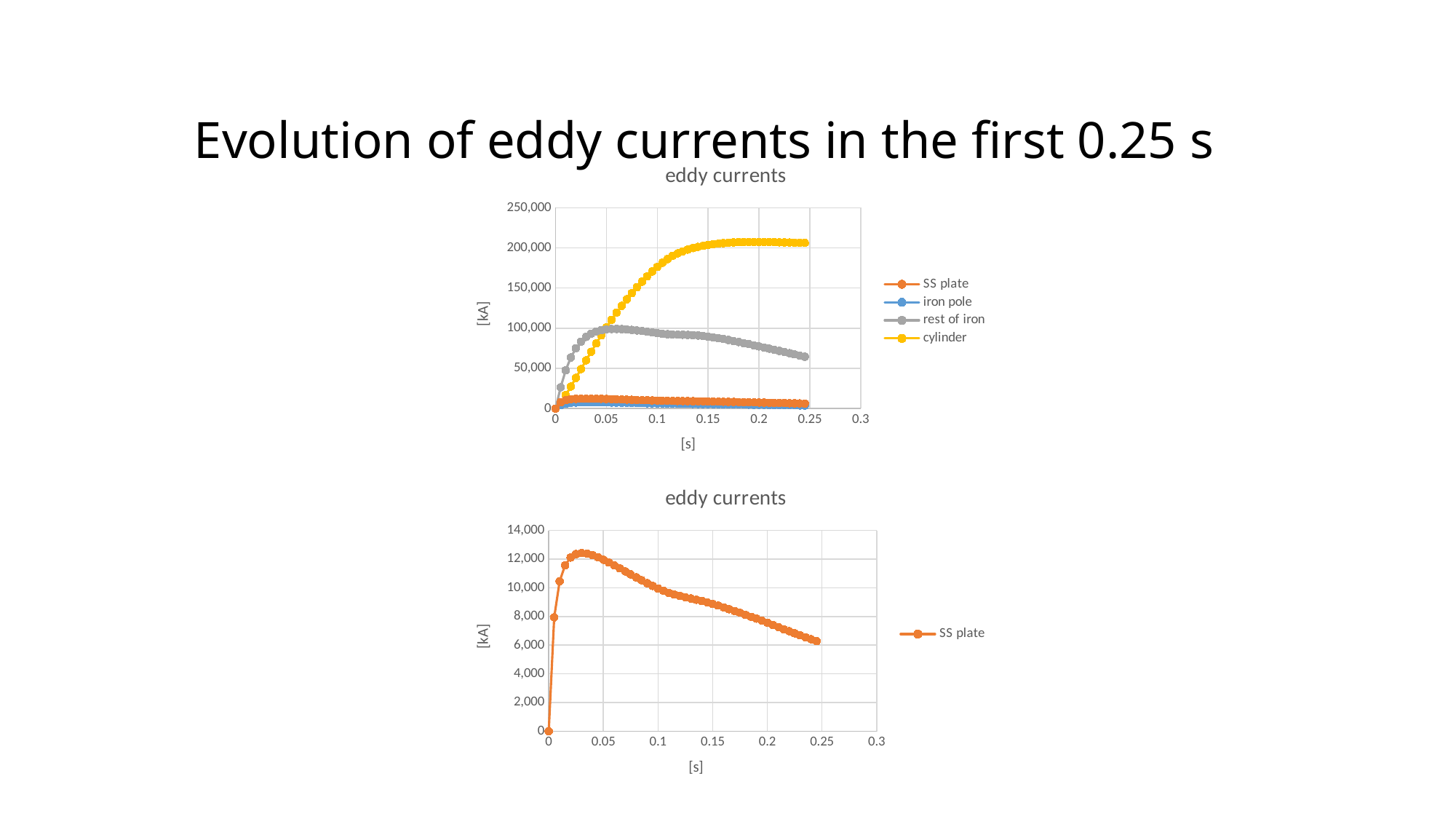
On the top chart, which series reaches the highest value? cylinder On the bottom chart, is the peak value of SS plate greater or less than 12,000? greater On the top chart, is the value for rest of iron at 0.2 s greater or less than 100,000? less On the bottom chart, does the SS plate value rise or fall between 0.05 s and 0.25 s? fall On the top chart, which series stays lowest throughout? iron pole On the top chart, how many series does the legend list? 4 On the bottom chart, is the value for SS plate at 0.2 s greater or less than 8,000? less What is the y-axis label on the top chart? [kA] What kind of chart is the top chart? line chart On the top chart, at 0.2 s, which is larger: cylinder or rest of iron? cylinder On the bottom chart, how many series does the legend list? 1